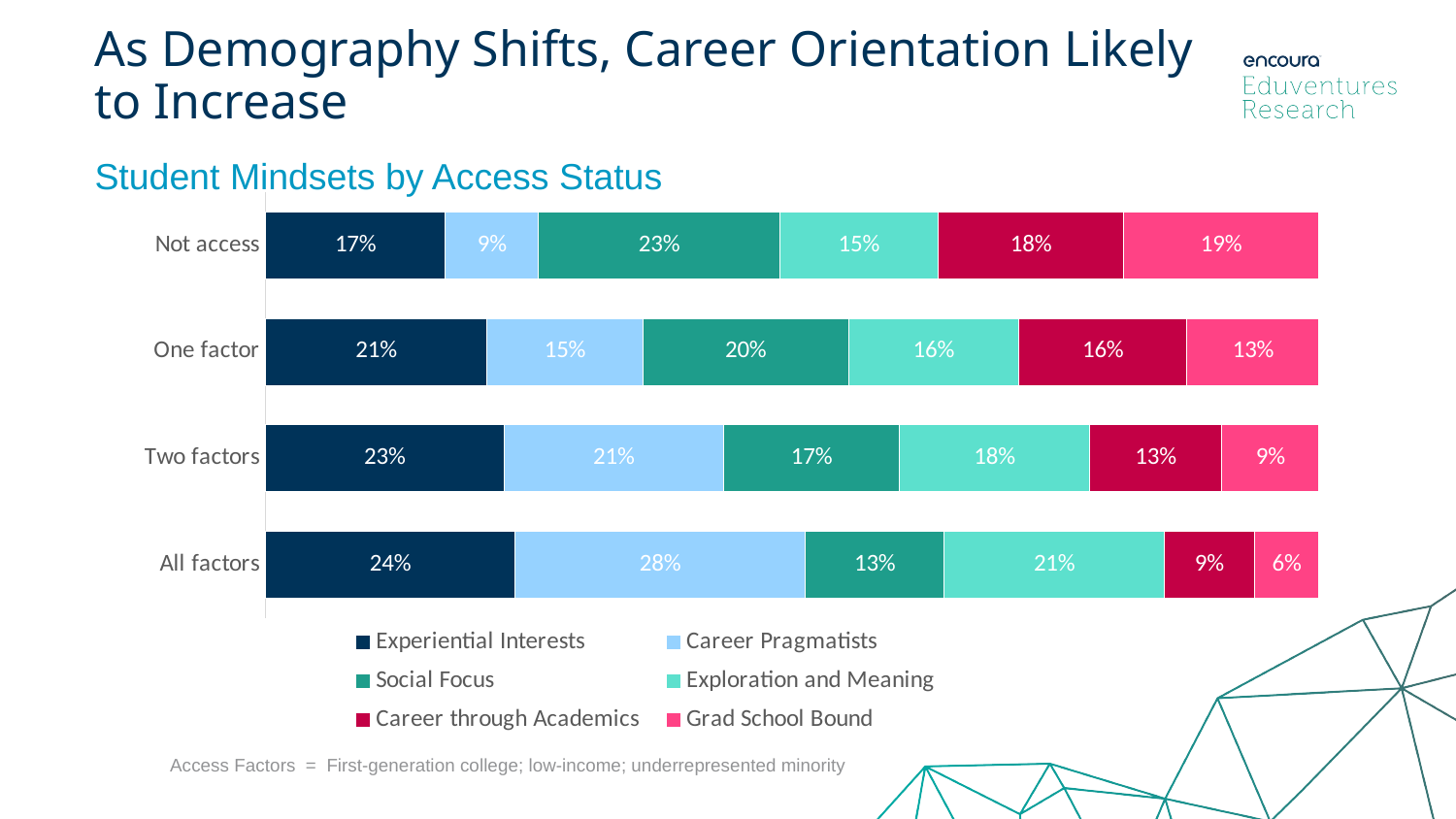
Which access status has the highest value for Experiential Interests? All factors Which access status has the lowest value for Grad School Bound? All factors What kind of chart is shown on the slide? Stacked bar chart Which is larger: Exploration and Meaning for Two factors or Exploration and Meaning for One factor? Two factors What is the value for Career through Academics in the One factor bar? 16% What is the value for Career Pragmatists in the All factors bar? 28% What is the value for Social Focus in the Not access bar? 23% How many access status categories are shown in the chart? 4 What is the title of the chart? Student Mindsets by Access Status What is the difference between the Career Pragmatists values for All factors and Not access? 19% What is the value for Grad School Bound in the Two factors bar? 9% How many series does the legend list? 6